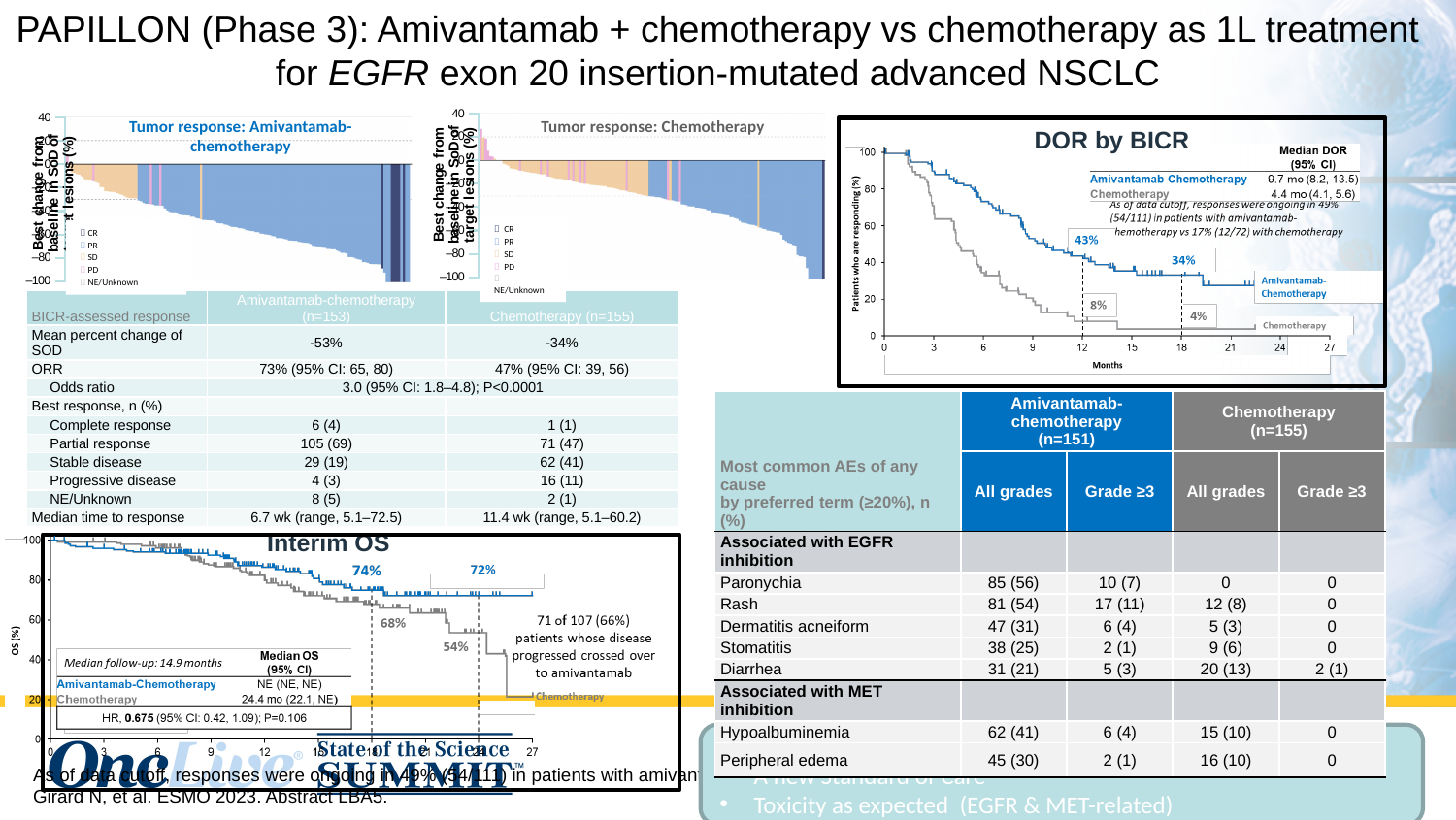
In the DOR by BICR chart, what is the highest percentage label printed on the curves? 43% How many categories does the legend of the Tumor response: Amivantamab-chemotherapy chart list? 5 In the DOR by BICR chart, what is the difference in median DOR between Amivantamab-Chemotherapy and Chemotherapy? 5.3 mo In the Interim OS chart, what is the median OS for Chemotherapy? 24.4 mo (22.1, NE) In the Interim OS chart, what is the hazard ratio (HR) shown? 0.675 In the DOR by BICR chart, what is the label on the x axis? Months In the Interim OS chart, what is the median follow-up? 14.9 months What kind of chart is the Tumor response: Chemotherapy chart? bar chart In the DOR by BICR chart, what is the median DOR for Amivantamab-Chemotherapy? 9.7 mo (8.2, 13.5) In the Interim OS chart, do the survival curves rise or fall as months increase? fall In the DOR by BICR chart, which arm has the longer median DOR? Amivantamab-Chemotherapy In the DOR by BICR chart, what is the median DOR for Chemotherapy? 4.4 mo (4.1, 5.6)